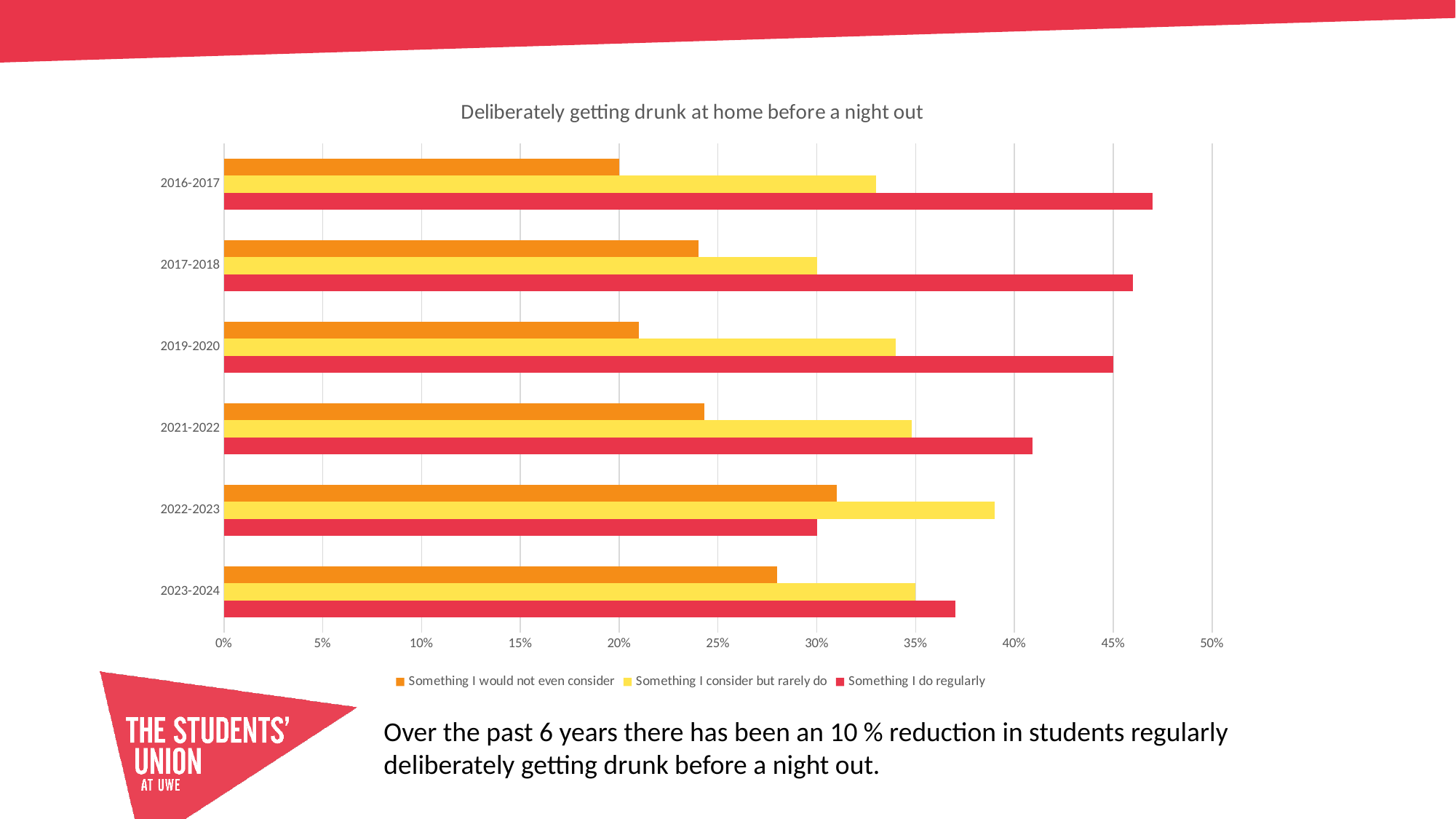
What kind of chart is shown on the slide? bar chart In 2022-2023, which is larger: 'Something I consider but rarely do' or 'Something I do regularly'? Something I consider but rarely do Is the value for 'Something I would not even consider' in 2023-2024 greater or less than 30%? less What is the title of the chart? Deliberately getting drunk at home before a night out Is the value for 'Something I do regularly' in 2016-2017 greater or less than 45%? greater What is the value for 'Something I do regularly' in 2022-2023? 30% What is the value for 'Something I would not even consider' in 2016-2017? 20% How many academic year categories are shown on the chart? 6 How many series does the legend list? 3 What is the value for 'Something I do regularly' in 2019-2020? 45% Which year has the lowest value for 'Something I do regularly'? 2022-2023 What is the value for 'Something I consider but rarely do' in 2017-2018? 30%